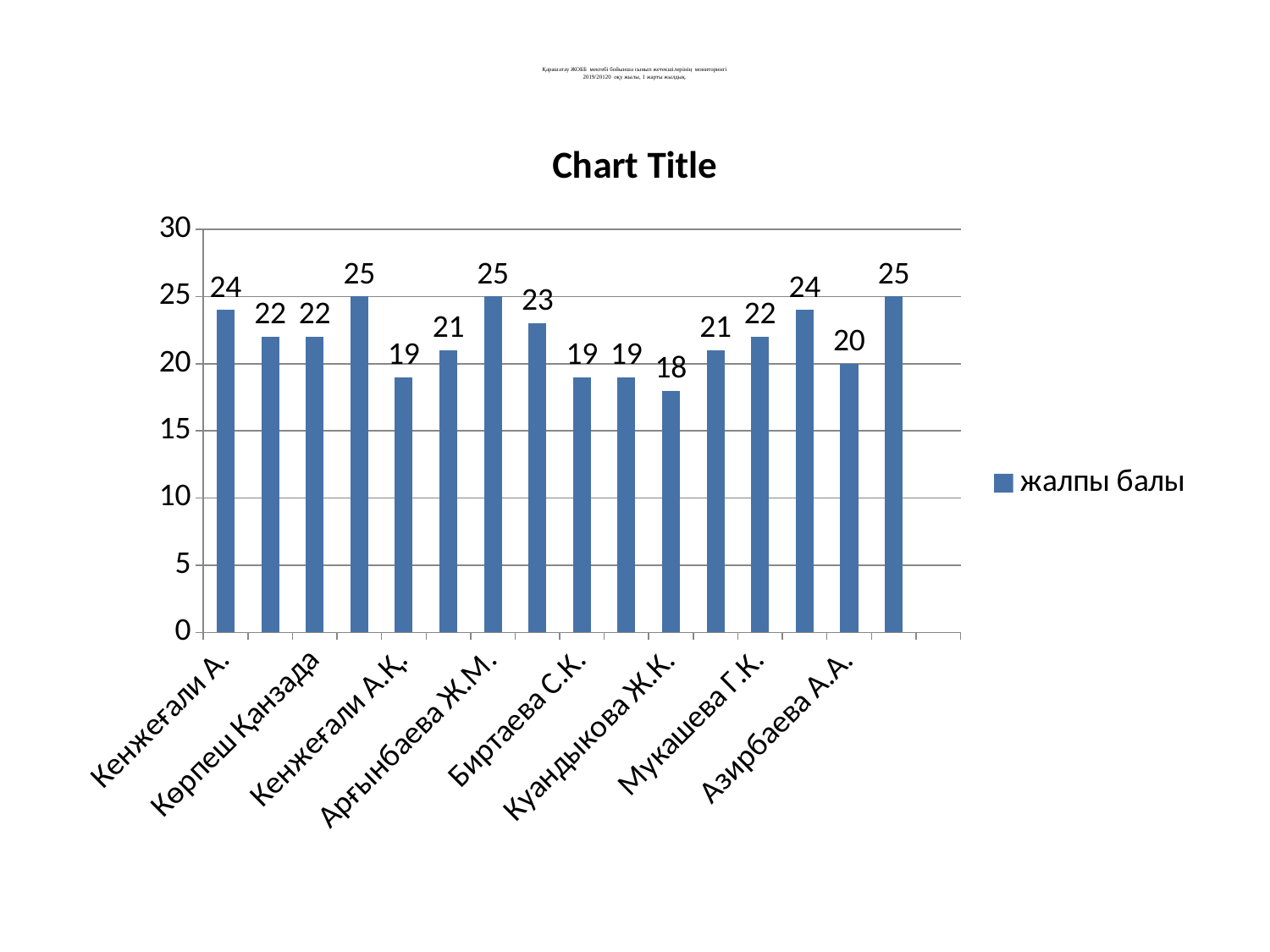
What is the highest value shown on the chart? 25 How many series does the legend list? 1 What is the legend entry for the series? жалпы балы What is the value for Куандыкова Ж.К.? 18 What is the difference between the values for Арғынбаева Ж.М. and Кенжеғали А.Қ.? 6 What is the value for Азирбаева А.А.? 20 Which labelled category has the lowest value? Куандыкова Ж.К. What is the value for Арғынбаева Ж.М.? 25 How many bars are plotted on the chart? 16 What kind of chart is shown? bar chart Which is larger, the value for Көрпеш Қанзада or the value for Биртаева С.К.? Көрпеш Қанзада What is the value for Кенжеғали А.? 24